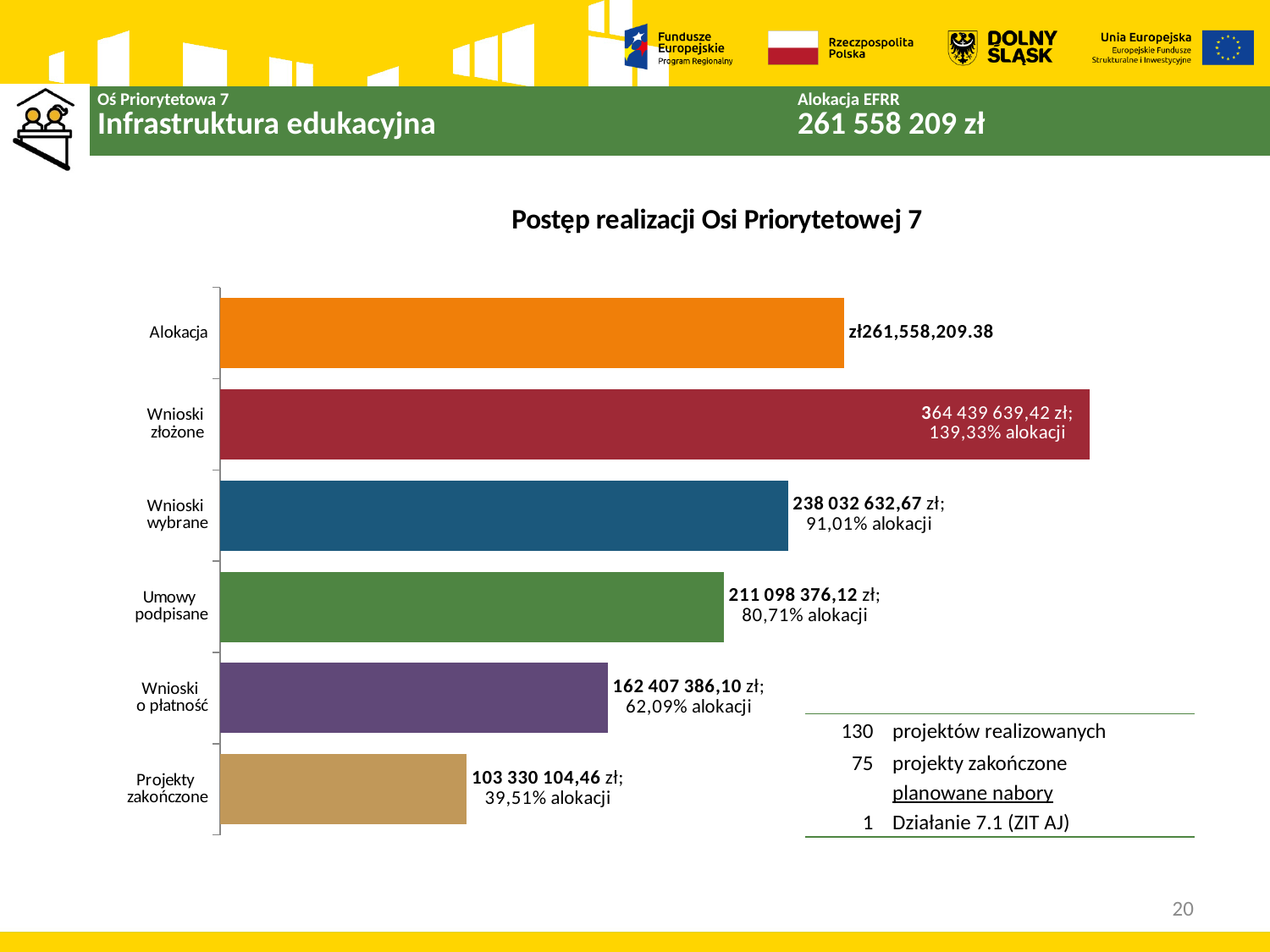
Which category has the highest value? Wnioski złożone What percentage of the allocation do Umowy podpisane represent? 80,71% alokacji What is the title of the chart? Postęp realizacji Osi Priorytetowej 7 What amount is shown for Projekty zakończone? 103 330 104,46 zł What kind of chart is shown on the slide? bar chart What percentage of the allocation do Wnioski o płatność represent? 62,09% alokacji Which category has the lowest value? Projekty zakończone What amount is shown for Wnioski złożone? 364 439 639,42 zł How many categories (bars) does the chart show? 6 What is the difference in percentage of allocation between Wnioski wybrane (91,01%) and Umowy podpisane (80,71%)? 10,30 percentage points What value is shown for Alokacja? zł261,558,209.38 Which is larger, Wnioski wybrane or Umowy podpisane? Wnioski wybrane